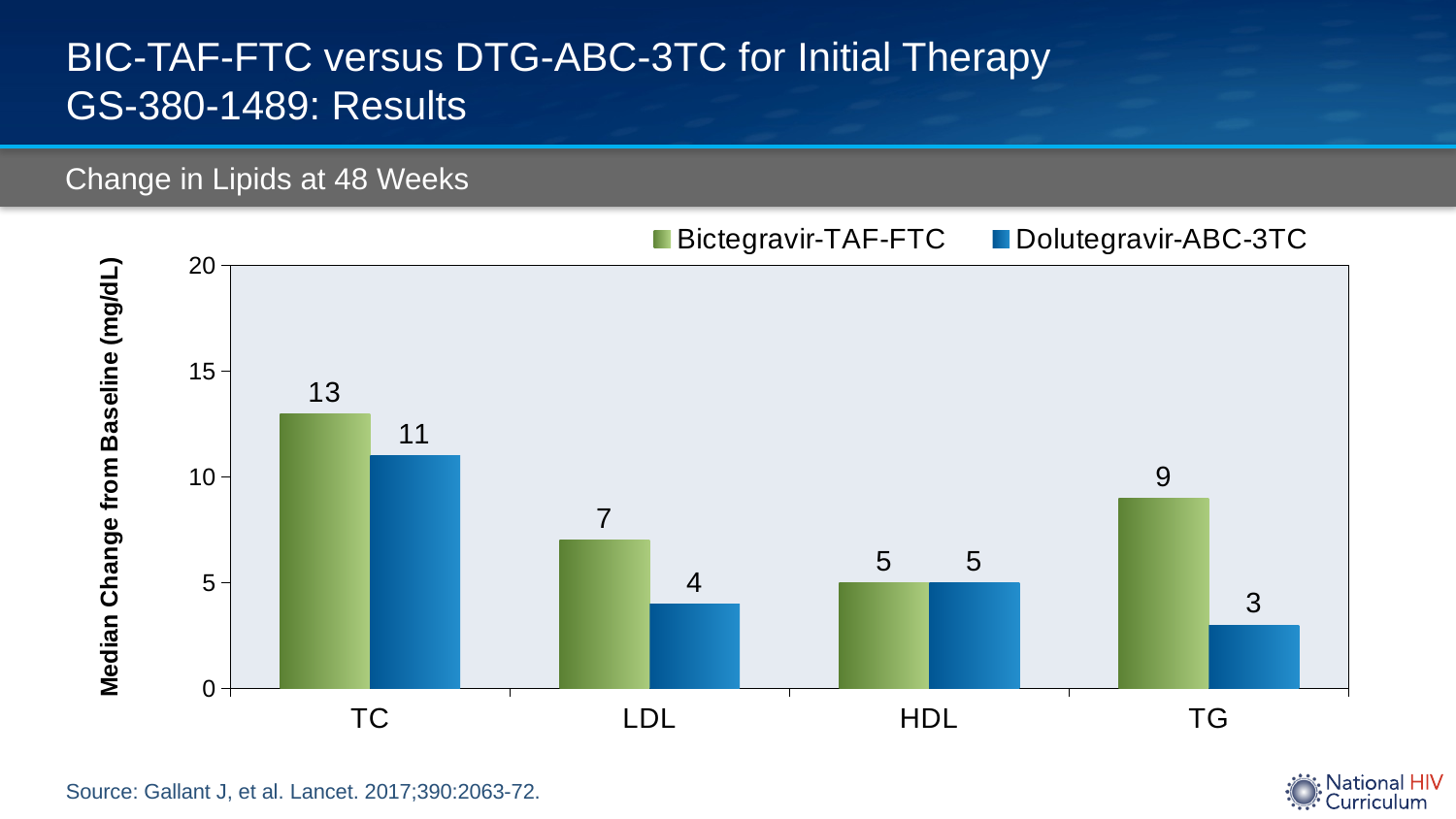
What is the median change from baseline in TC for Bictegravir-TAF-FTC? 13 What is the median change from baseline in TG for Dolutegravir-ABC-3TC? 3 What is the difference between the Bictegravir-TAF-FTC and Dolutegravir-ABC-3TC values for TG? 6 What is the label of the y axis? Median Change from Baseline (mg/dL) Which lipid category has the highest value for Bictegravir-TAF-FTC? TC Which is larger for LDL: the Bictegravir-TAF-FTC value or the Dolutegravir-ABC-3TC value? Bictegravir-TAF-FTC What kind of chart is shown on the slide? bar chart Is the Bictegravir-TAF-FTC value for TC greater or less than 10? greater How many lipid categories are shown on the x axis? 4 What is the median change from baseline in LDL for Dolutegravir-ABC-3TC? 4 Which lipid category has the lowest value for Dolutegravir-ABC-3TC? TG How many series does the legend list? 2